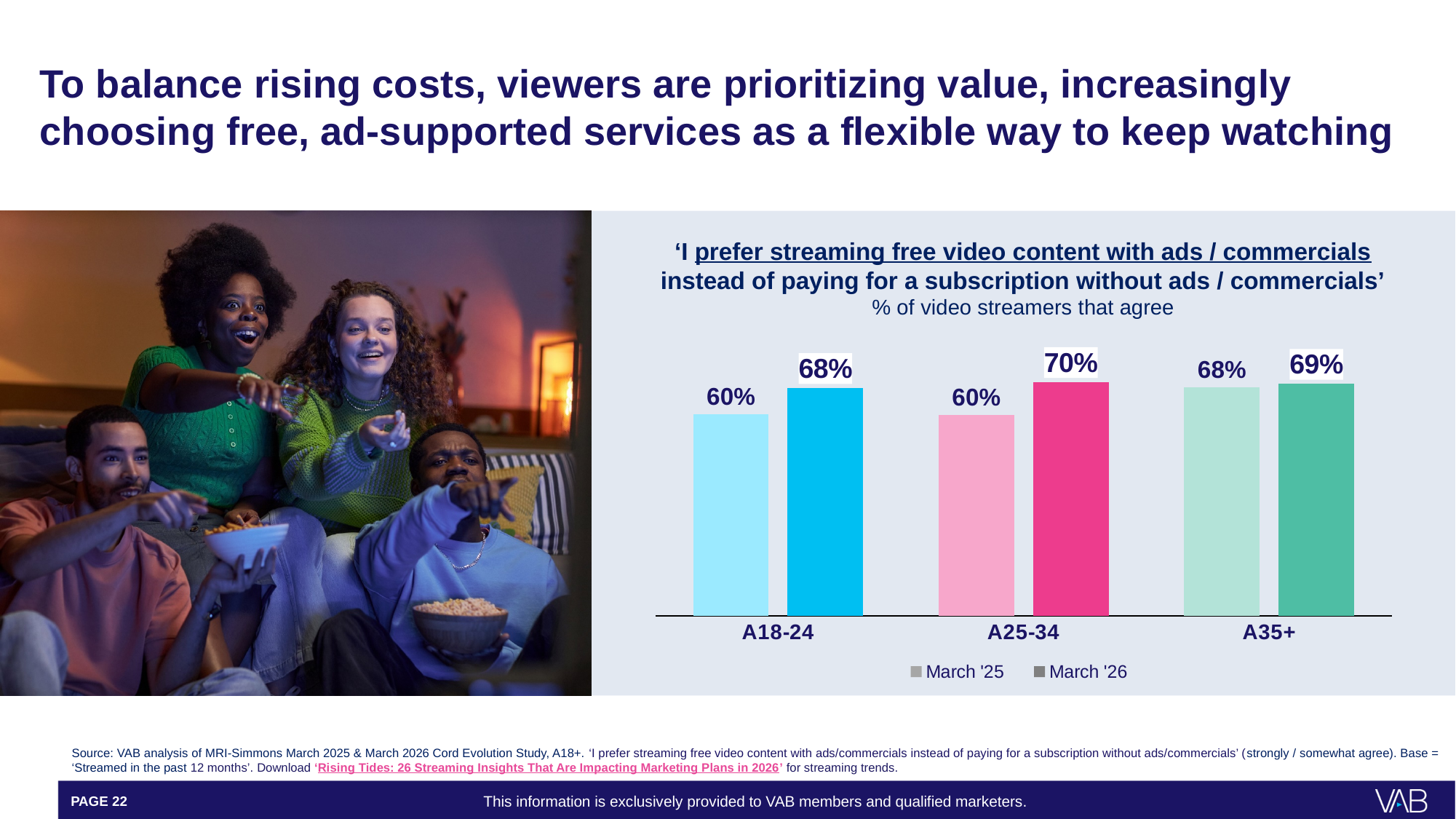
What is the March '26 value for A35+? 69% Which age group has the highest March '26 value? A25-34 Which is larger, the March '26 value for A18-24 or the March '26 value for A25-34? A25-34 What percentage of A18-24 video streamers agreed in March '26? 68% How many age groups are shown on the x axis? 3 What are the two series named in the legend? March '25 and March '26 What is the difference between the March '25 and March '26 values for A25-34? 10 percentage points What kind of chart is shown on the slide? Bar chart What percentage of A25-34 video streamers agreed in March '25? 60% What is the difference between the March '25 and March '26 values for A35+? 1 percentage point How many series does the legend list? 2 Which age group has the highest March '25 value? A35+